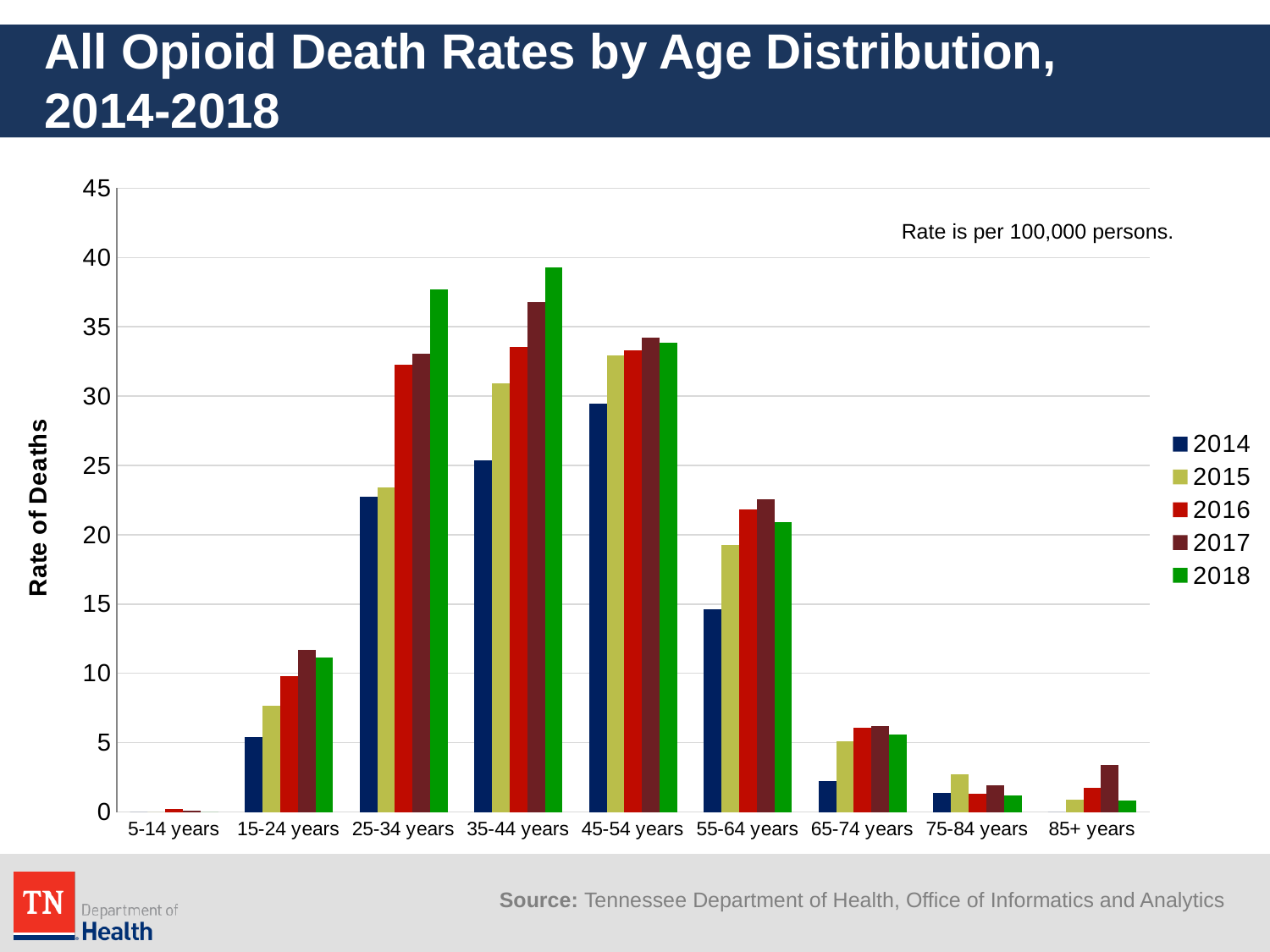
How many series (years) does the legend list? 5 Is the 2015 value for 55-64 years greater or less than 20? less What kind of chart is shown on the slide? Bar chart Is the 2014 value for 25-34 years greater or less than 20? greater For the 35-44 years group, which year has the larger value, 2014 or 2018? 2018 Which age group has the highest 2018 death rate? 35-44 years For the 55-64 years group, which year has the larger value, 2017 or 2018? 2017 For the 15-24 years group, do the values rise or fall from 2014 to 2017? rise Which age group has the lowest death rates across all years? 5-14 years How many age groups are shown on the x axis? 9 Is the 2018 value for 25-34 years greater or less than 35? greater What is the label on the y axis? Rate of Deaths